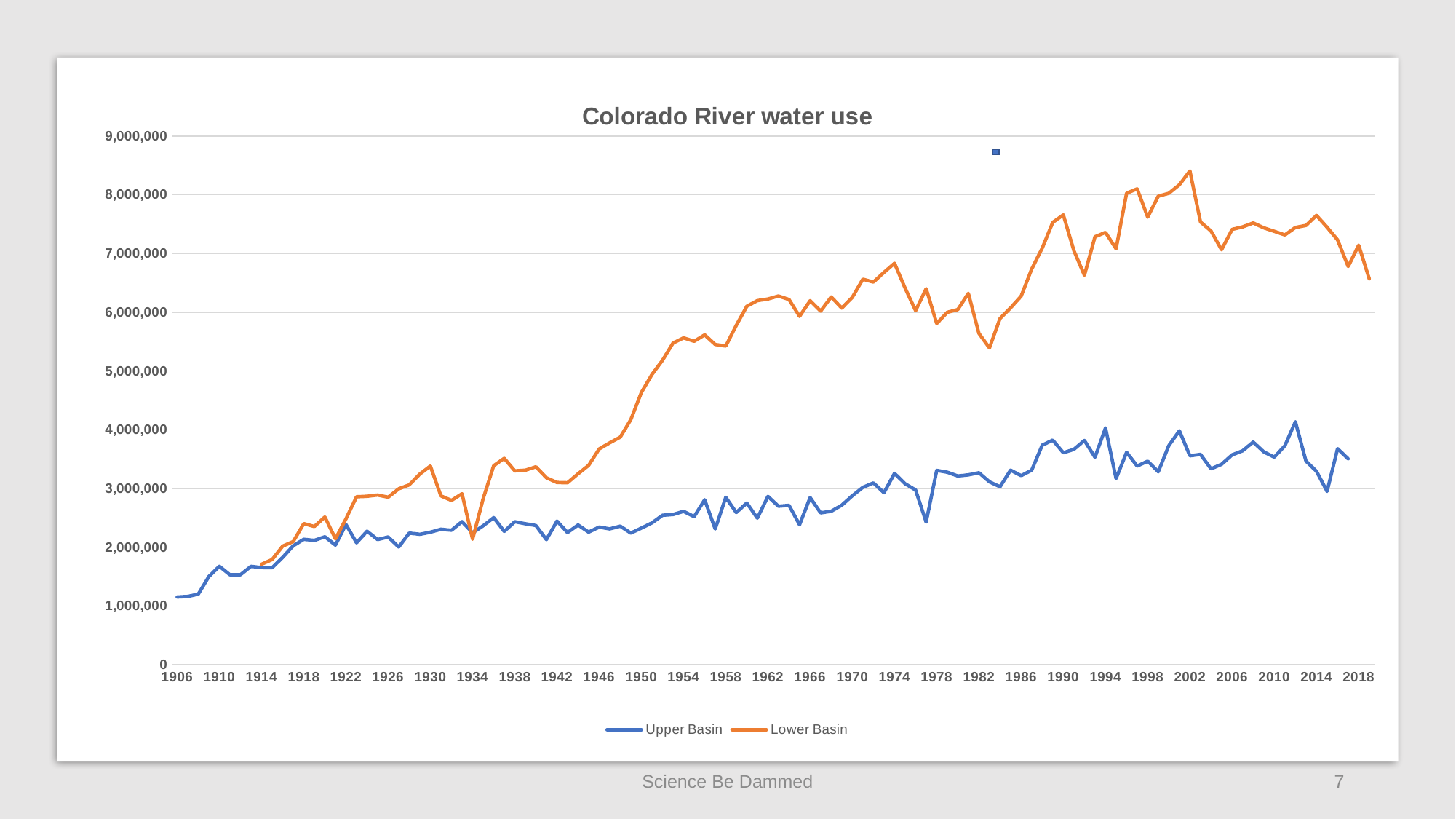
Is the value for Lower Basin in 2002 greater or less than 8,000,000? greater What kind of chart is shown on the slide? line chart Is the value for Upper Basin in 1906 greater or less than 2,000,000? less Which series is drawn in orange? Lower Basin Is the value for Lower Basin in 1934 greater or less than 3,000,000? less How many series does the legend list? 2 Overall, does the Lower Basin line rise or fall from 1914 to 2002? rise Which series reaches the highest value on the chart? Lower Basin What is the title of the chart? Colorado River water use